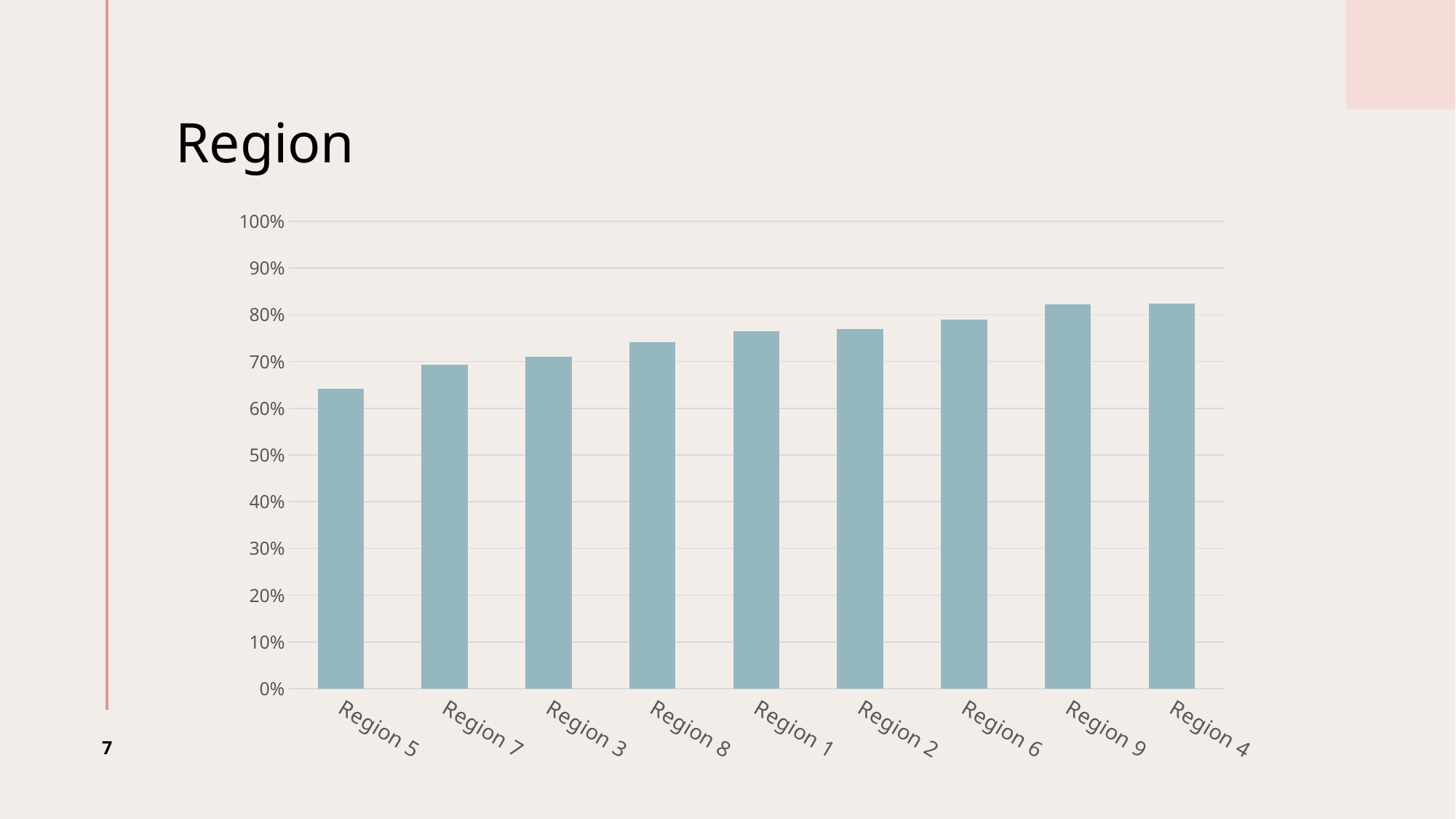
Do the bar values rise or fall from left to right across the chart? rise Is the value for Region 8 greater or less than 70%? greater Is the value for Region 1 greater or less than 80%? less Which region has the lowest value on the chart? Region 5 Is the value for Region 5 greater or less than 60%? greater How many regions are plotted on the chart? 9 What kind of chart is shown on the slide? bar chart Which has the larger value, Region 7 or Region 6? Region 6 Which has the larger value, Region 5 or Region 8? Region 8